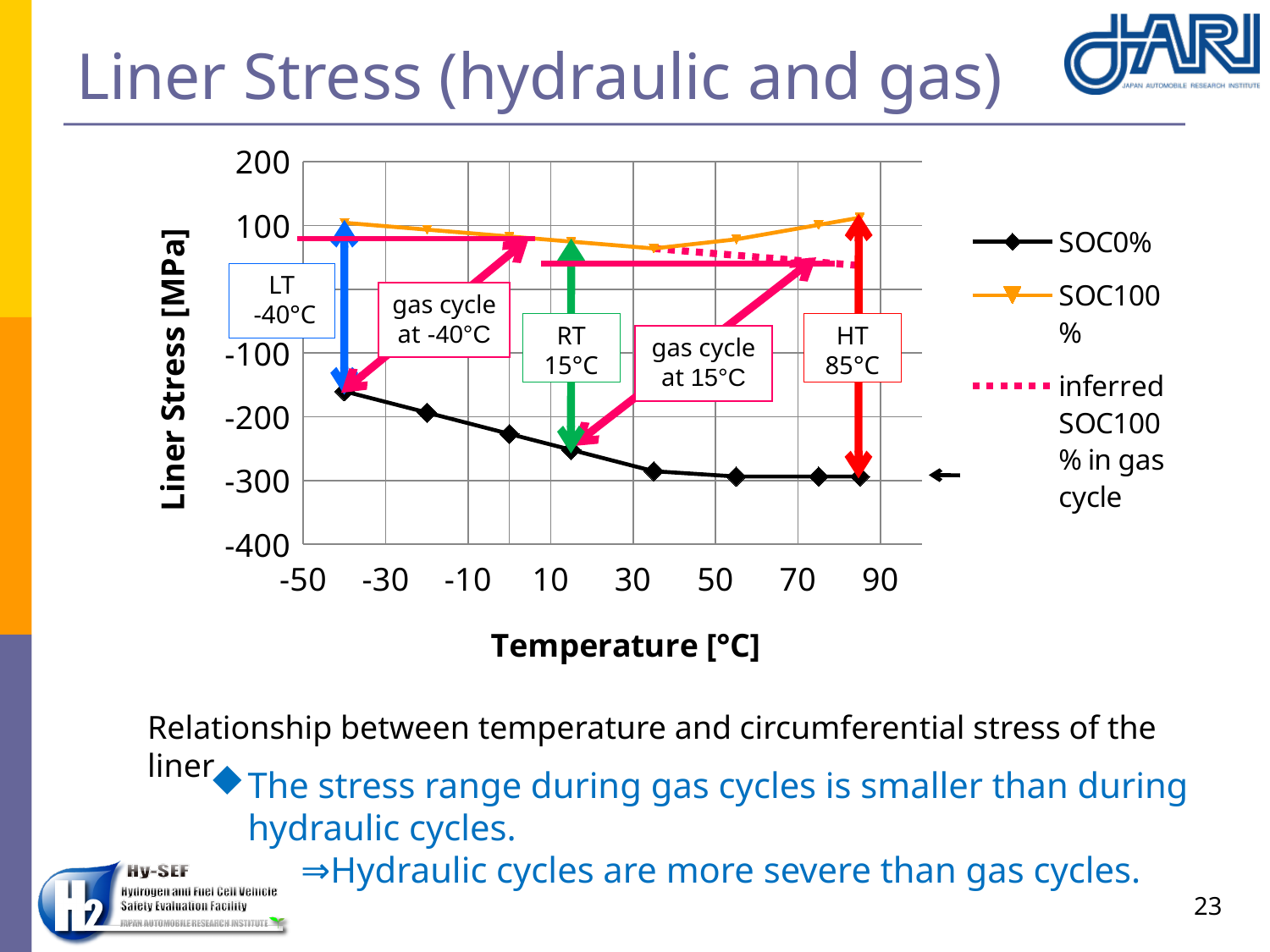
Is the SOC0% value at -40°C greater or less than -100? less How many series does the chart legend list? 3 What is the label of the y axis? Liner Stress [MPa] How many data points are plotted for the SOC0% series? 8 At 15°C, which series has the larger liner stress, SOC0% or SOC100%? SOC100% At which temperature does the SOC0% series reach its highest value? -40°C Is the SOC0% value at 85°C greater or less than -200? less What is the label of the x axis? Temperature [°C] Is the SOC100% value at -40°C greater or less than 0? greater What kind of chart is shown on the slide? Line chart Does the SOC0% series rise or fall as temperature increases along the x axis? Fall